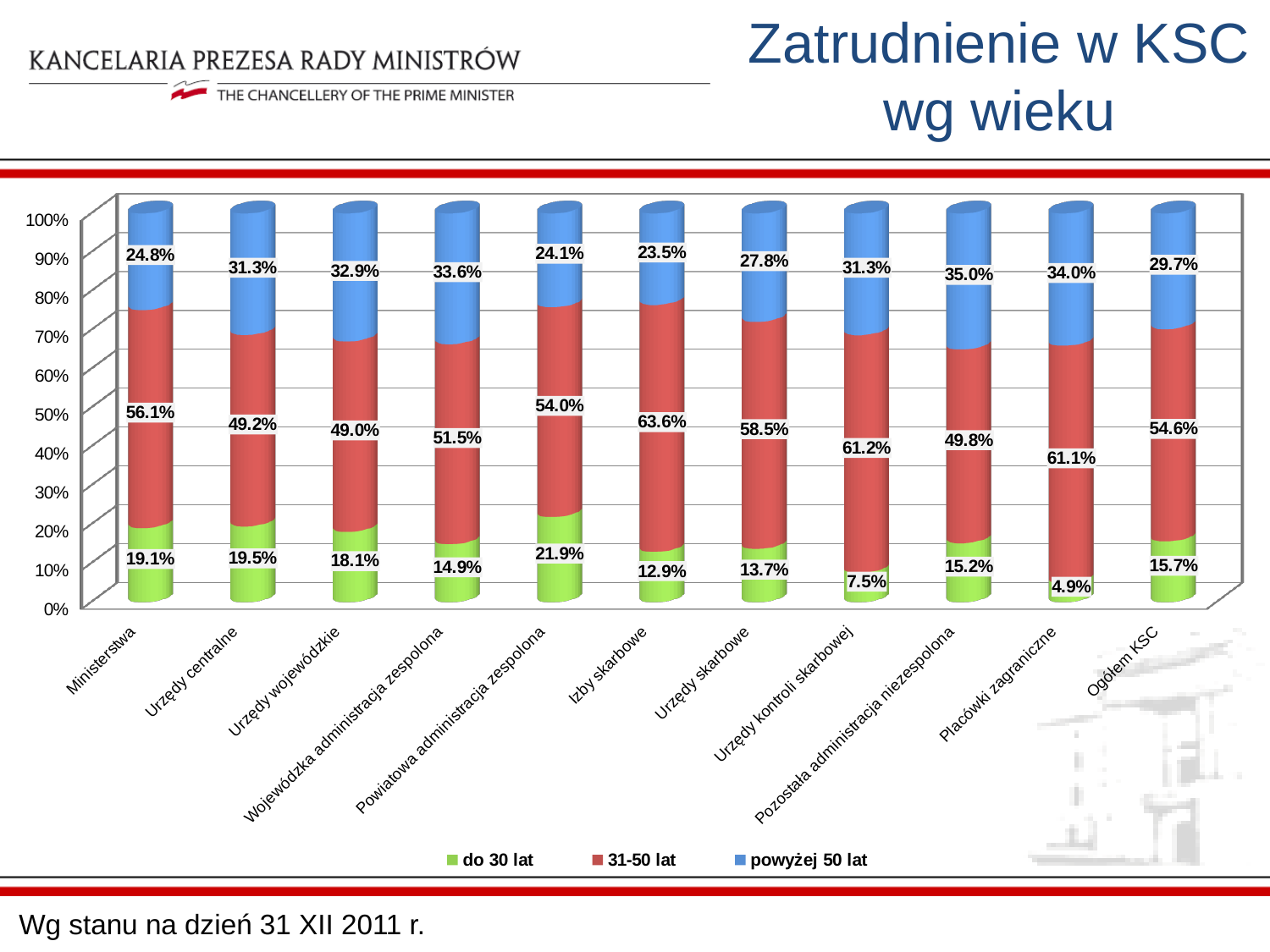
Which category has the lowest value for the 'do 30 lat' series? Placówki zagraniczne Which is larger: the 'powyżej 50 lat' value for Urzędy wojewódzkie or for Urzędy skarbowe? Urzędy wojewódzkie What is the value for the 'powyżej 50 lat' series for Ogółem KSC? 29.7% What is the value for the '31-50 lat' series for Izby skarbowe? 63.6% What is the title of the slide containing the chart? Zatrudnienie w KSC wg wieku What kind of chart is shown on the slide? Stacked bar chart Which category has the highest value for the 'powyżej 50 lat' series? Pozostała administracja niezespolona What is the difference between the '31-50 lat' value and the 'do 30 lat' value for Ministerstwa? 37.0 percentage points Which category has the highest value for the 'do 30 lat' series? Powiatowa administracja zespolona What is the value for the 'do 30 lat' series for Ministerstwa? 19.1% How many categories are shown on the x axis? 11 How many series does the legend list? 3